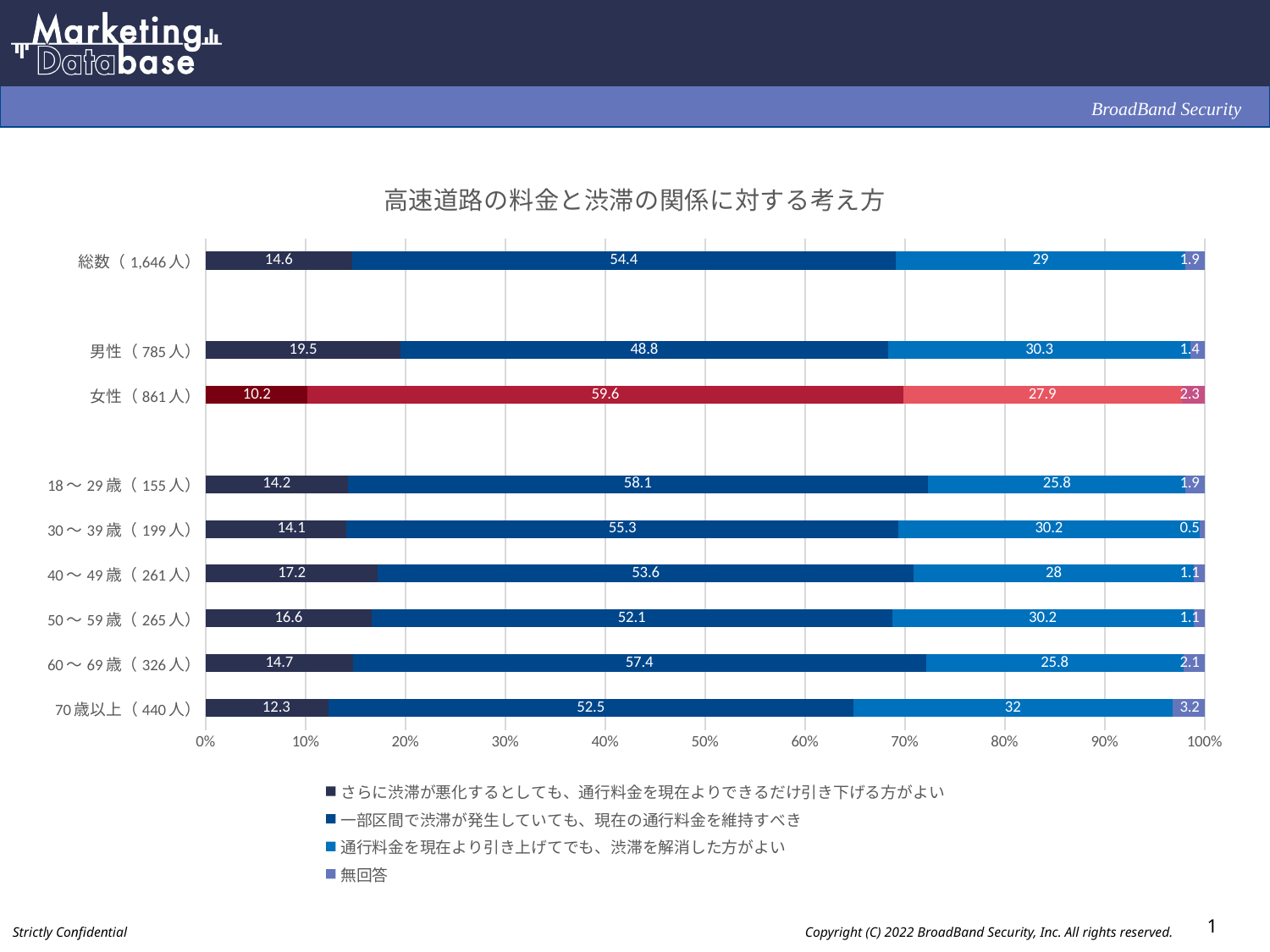
What is the value of the first series (さらに渋滞が悪化するとしても、通行料金を現在よりできるだけ引き下げる方がよい) for 総数 (1,646人)? 14.6 What is the title of the chart? 高速道路の料金と渋滞の関係に対する考え方 Which category has the lowest value for the second series (一部区間で渋滞が発生していても、現在の通行料金を維持すべき)? 男性 (785人) What is the 無回答 value for 30～39歳 (199人)? 0.5 What is the value of the second series (一部区間で渋滞が発生していても、現在の通行料金を維持すべき) for 女性 (861人)? 59.6 What is the difference between the first-series values for 男性 (785人) and 女性 (861人)? 9.3 Which category has the highest value for the first series (さらに渋滞が悪化するとしても、通行料金を現在よりできるだけ引き下げる方がよい)? 男性 (785人) How many categories (respondent groups) are plotted on the chart? 9 What type of chart is shown on the slide? Stacked bar chart How many series does the legend list? 4 Which is larger: the third-series value for 70歳以上 (440人) or for 18～29歳 (155人)? 70歳以上 (440人) What is the value of the third series (通行料金を現在より引き上げてでも、渋滞を解消した方がよい) for 70歳以上 (440人)? 32